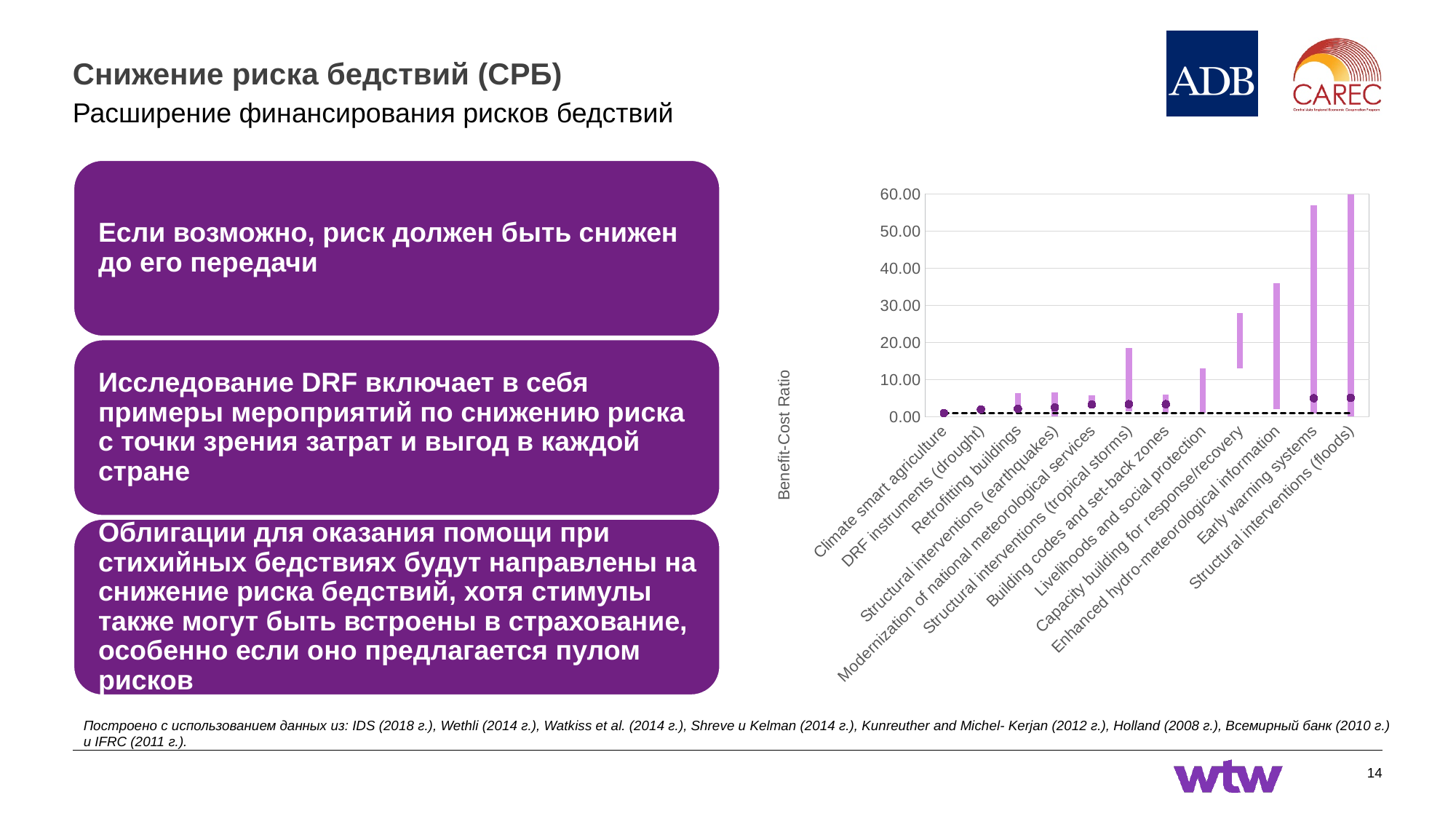
Which category has the highest benefit-cost ratio in the chart? Structural interventions (floods) What kind of chart is shown on the slide? bar chart Is the top of the bar for Livelihoods and social protection greater or less than 10.00? greater Which category has the lowest benefit-cost ratio in the chart? Climate smart agriculture Is the top of the bar for Structural interventions (tropical storms) greater or less than 20.00? less Is the top of the bar for Capacity building for response/recovery greater or less than 30.00? less Which has a higher benefit-cost ratio: Early warning systems or Enhanced hydro-meteorological information? Early warning systems How many categories are shown on the x axis of the chart? 12 What is the label of the y axis of the chart? Benefit-Cost Ratio Do the benefit-cost ratios generally rise or fall from left to right along the x axis? rise